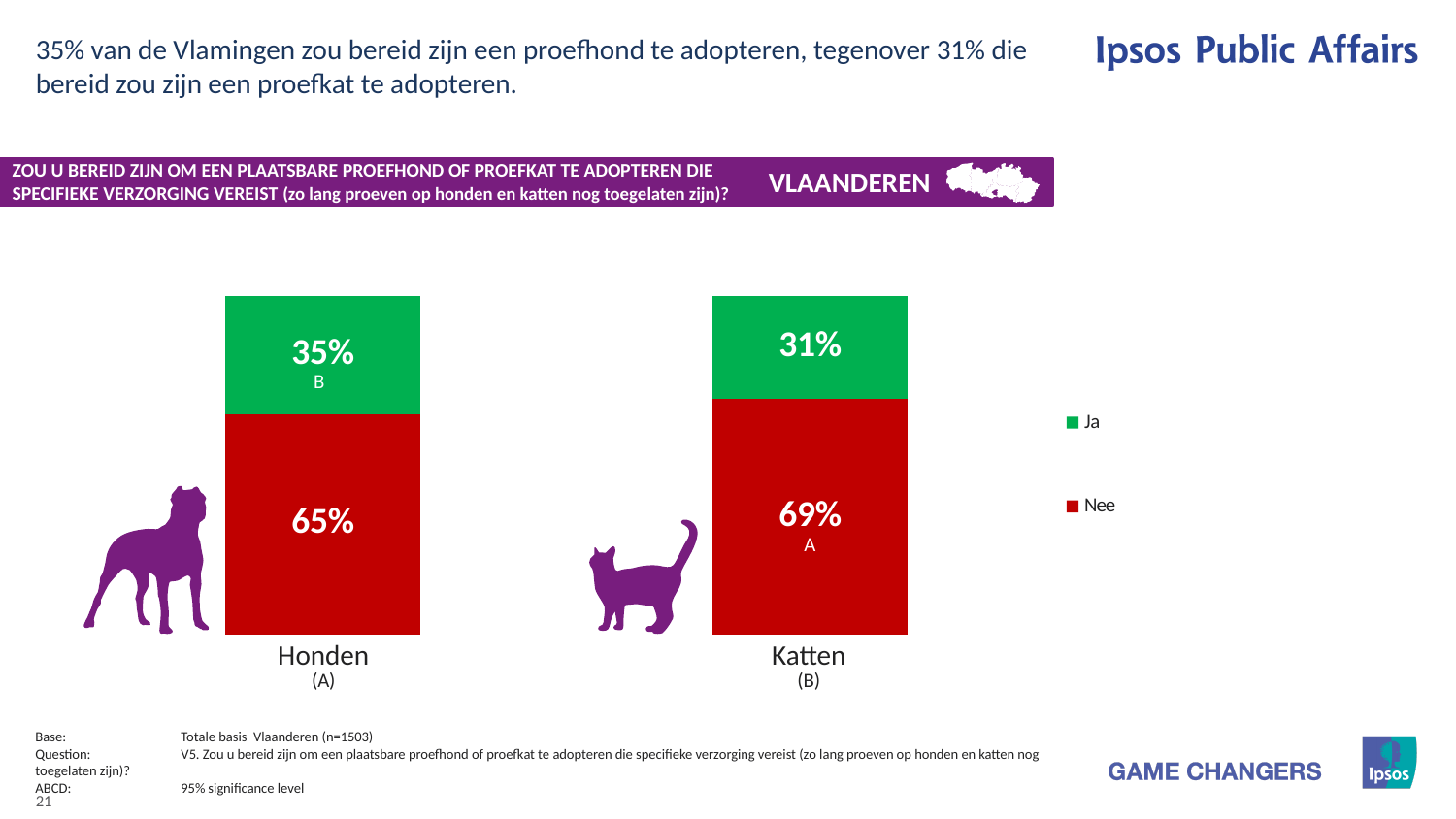
Which category has the highest 'Nee' value? Katten Which category has the higher 'Ja' share, Honden or Katten? Honden What is the 'Ja' value for Katten? 31% What is the total of the stacked bar for Honden? 100% What percentage of respondents answered 'Ja' for Honden? 35% How many categories are shown on the x axis? 2 What is the 'Nee' value for Honden? 65% What is the difference between the 'Ja' values for Honden and Katten? 4% What percentage of respondents answered 'Nee' for Katten? 69% How many series does the legend list? 2 What is the difference between the 'Nee' values for Katten and Honden? 4% What kind of chart is shown on the slide? Stacked bar chart